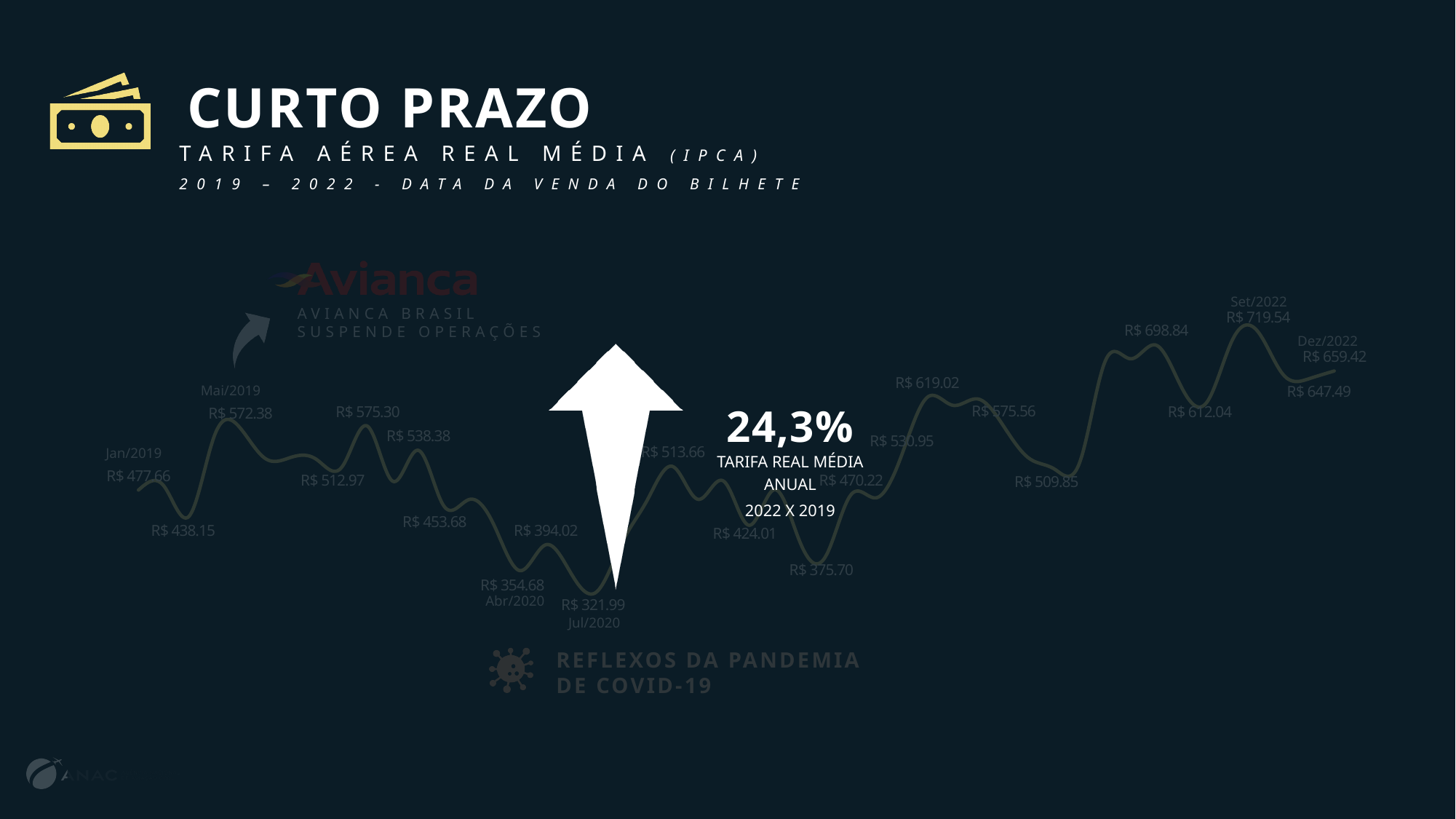
What kind of chart is shown on the slide? line chart Which is larger, the value for Set/2022 or the value for Dez/2022? Set/2022 What is the difference between the values for Mai/2019 and Abr/2020? R$ 217.70 What percentage change in the annual average real fare (2022 vs 2019) is highlighted on the slide? 24,3% Which labelled month has the highest value? Set/2022 What is the value for Abr/2020? R$ 354.68 What is the difference between the values for Set/2022 and Jan/2019? R$ 241.88 What is the value for Set/2022? R$ 719.54 What is the value for Dez/2022? R$ 659.42 Which labelled month has the lowest value? Jul/2020 What is the value for Jul/2020? R$ 321.99 What is the value for Jan/2019? R$ 477.66